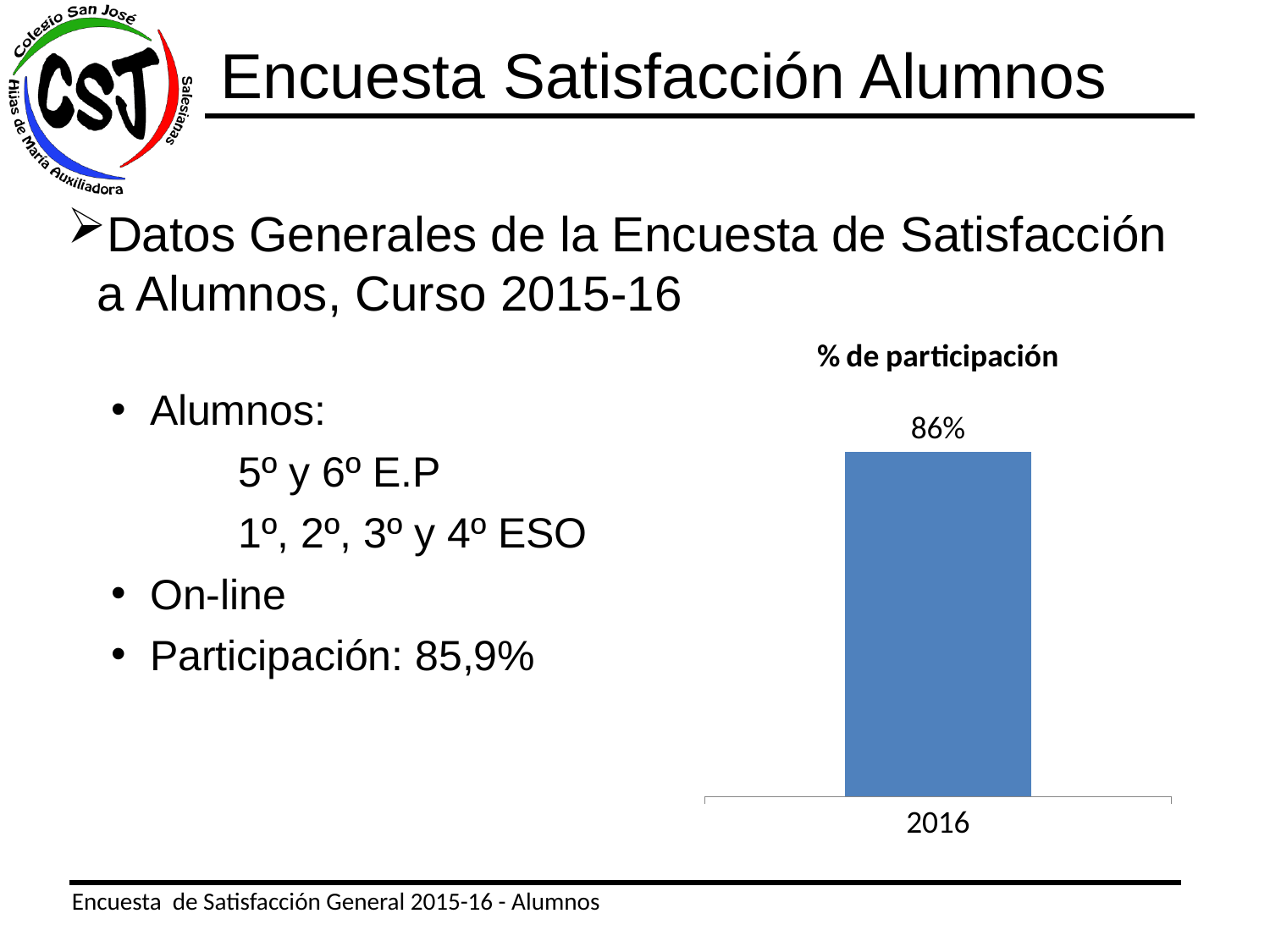
Is the value for 2016 in the chart greater or less than 50%? greater What is the title of the chart? % de participación How many categories are plotted in the chart? 1 What is the value shown for 2016 in the chart? 86% What kind of chart is shown on the slide? bar chart Which category label appears on the x axis of the chart? 2016